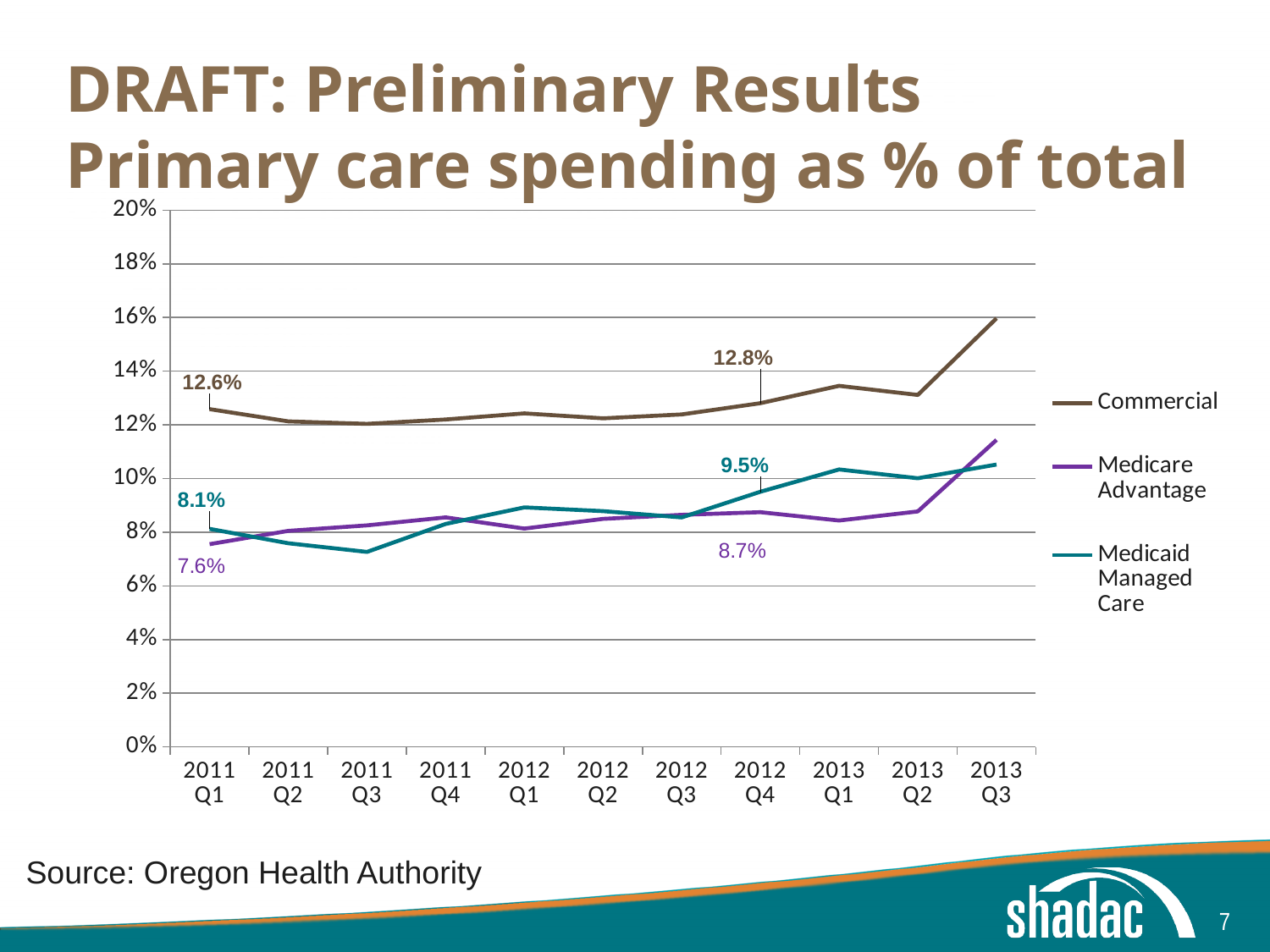
What is the Medicare Advantage value in 2012 Q4? 8.7% What is the Medicaid Managed Care value in 2012 Q4? 9.5% How many series does the legend list? 3 What is the Commercial value in 2011 Q1? 12.6% What kind of chart is shown on the slide? line chart By how many percentage points did the Medicaid Managed Care value change from 2011 Q1 to 2012 Q4? 1.4 percentage points How many quarters are shown on the x axis? 11 Is the Commercial value in 2013 Q3 greater or less than 14%? greater Which series has the highest value in 2012 Q4? Commercial In 2011 Q1, which was larger: Medicaid Managed Care or Medicare Advantage? Medicaid Managed Care By how many percentage points did the Commercial value change from 2011 Q1 to 2012 Q4? 0.2 percentage points What is the Medicare Advantage value in 2011 Q1? 7.6%